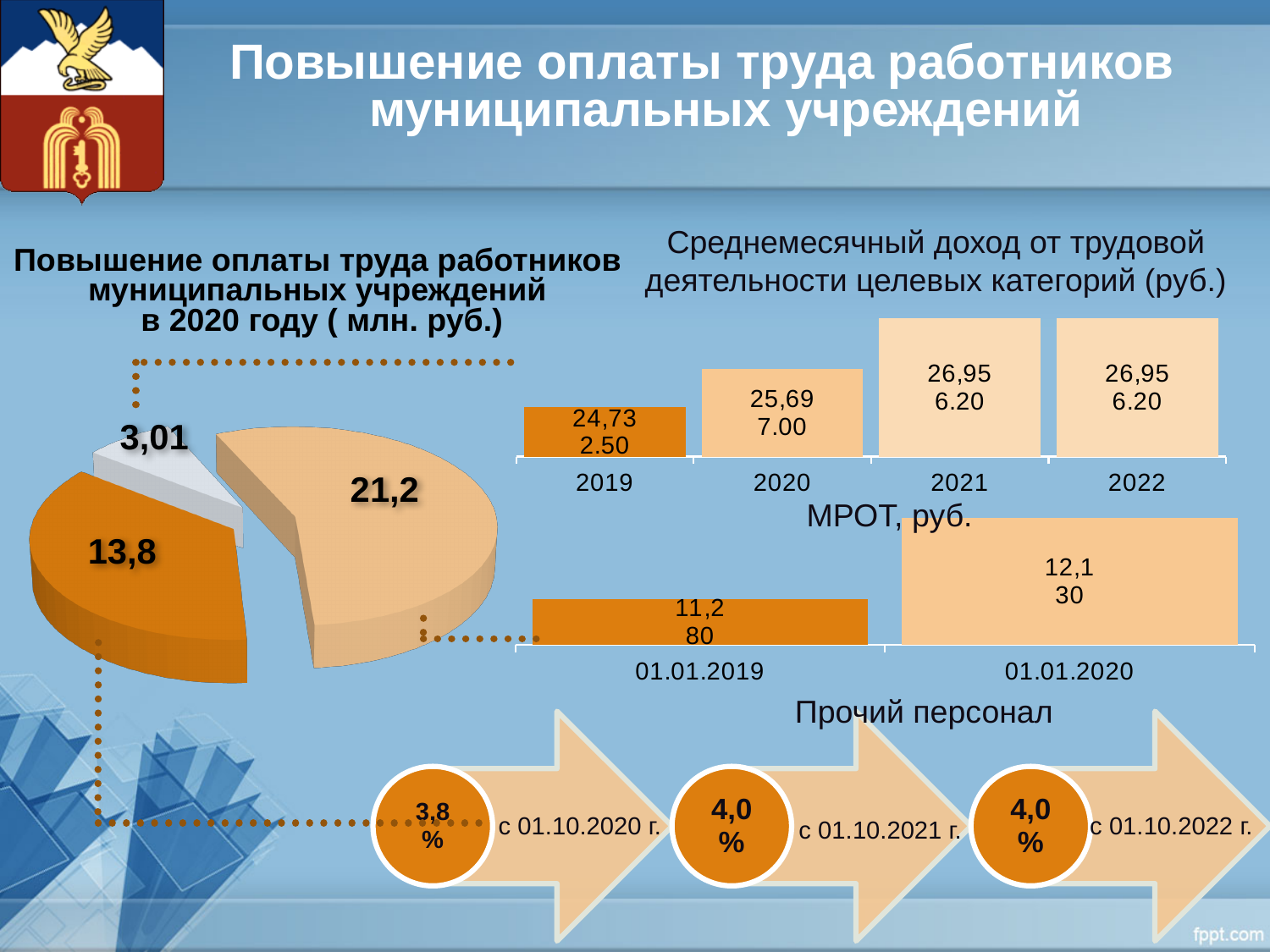
In the chart 'Среднемесячный доход от трудовой деятельности целевых категорий (руб.)', do the values rise or fall from 2019 to 2021? rise What is the total of the three slices in the pie chart on the left of the slide? 38,01 What type of chart is the chart titled 'Среднемесячный доход от трудовой деятельности целевых категорий (руб.)'? bar chart In the chart 'МРОТ, руб.', which date has the higher value, 01.01.2019 or 01.01.2020? 01.01.2020 In the chart 'Среднемесячный доход от трудовой деятельности целевых категорий (руб.)', how many years are shown on the x axis? 4 What type of chart is the chart titled 'Повышение оплаты труда работников муниципальных учреждений в 2020 году ( млн. руб.)'? pie chart What is the smallest value shown in the pie chart on the left of the slide? 3,01 In the chart 'МРОТ, руб.', what is the value for 01.01.2020? 12,130 What is the largest value shown in the pie chart on the left of the slide? 21,2 In the chart 'Среднемесячный доход от трудовой деятельности целевых категорий (руб.)', what is the value for 2019? 24,732.50 In the chart 'Среднемесячный доход от трудовой деятельности целевых категорий (руб.)', what is the value for 2020? 25,697.00 How many slices does the pie chart on the left of the slide have? 3